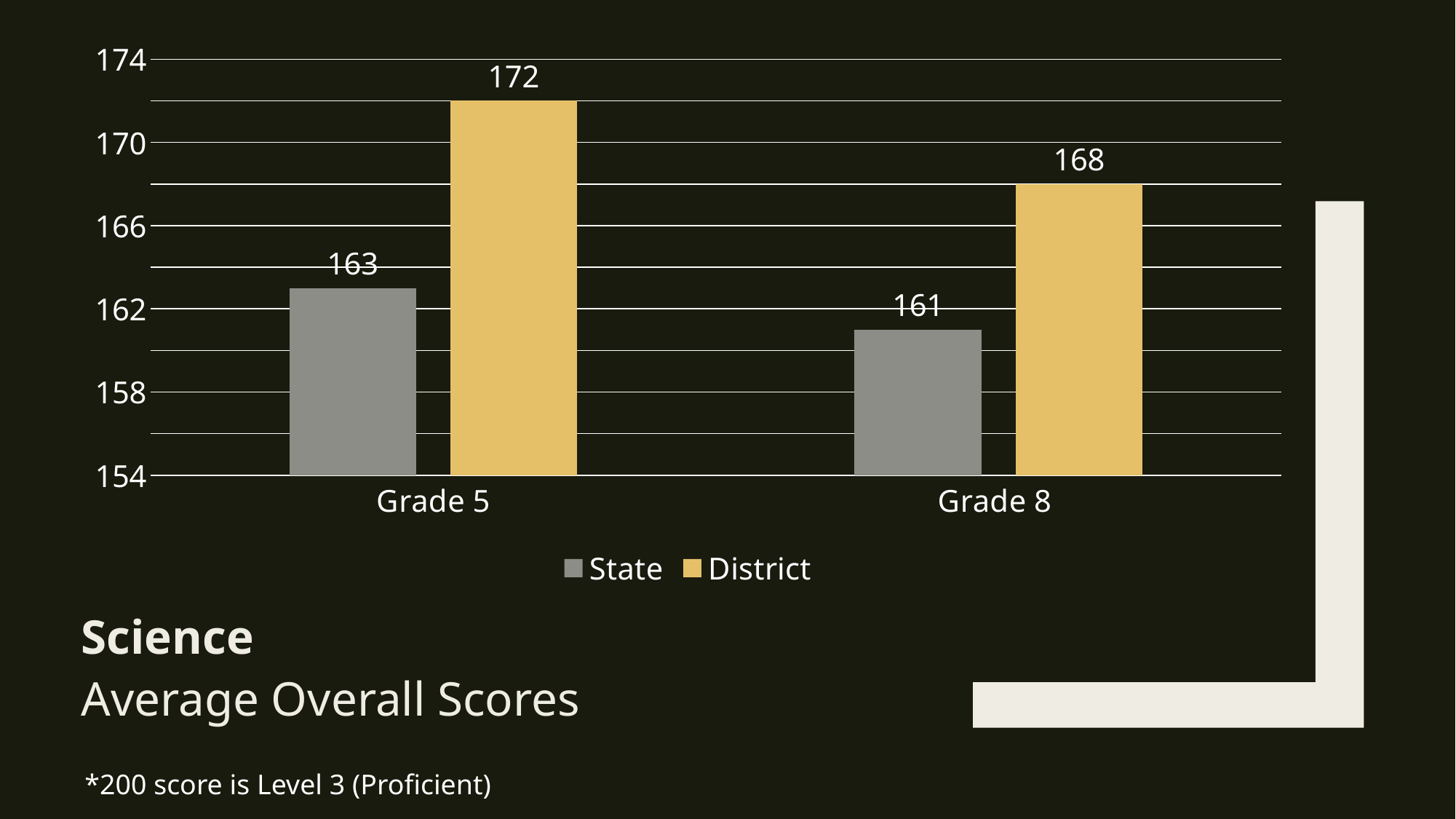
Which bar shows the lowest value on the chart? State, Grade 8 What is the District score for Grade 5? 172 Which is larger for Grade 8, the State score or the District score? District What is the District score for Grade 8? 168 What is the difference between the District and State scores for Grade 8? 7 Which colour represents the District series? Yellow How many series does the legend list? 2 What kind of chart is shown on the slide? Bar chart What is the State score for Grade 8? 161 What is the difference between the District and State scores for Grade 5? 9 Which grade has the highest District score? Grade 5 What is the State score for Grade 5? 163